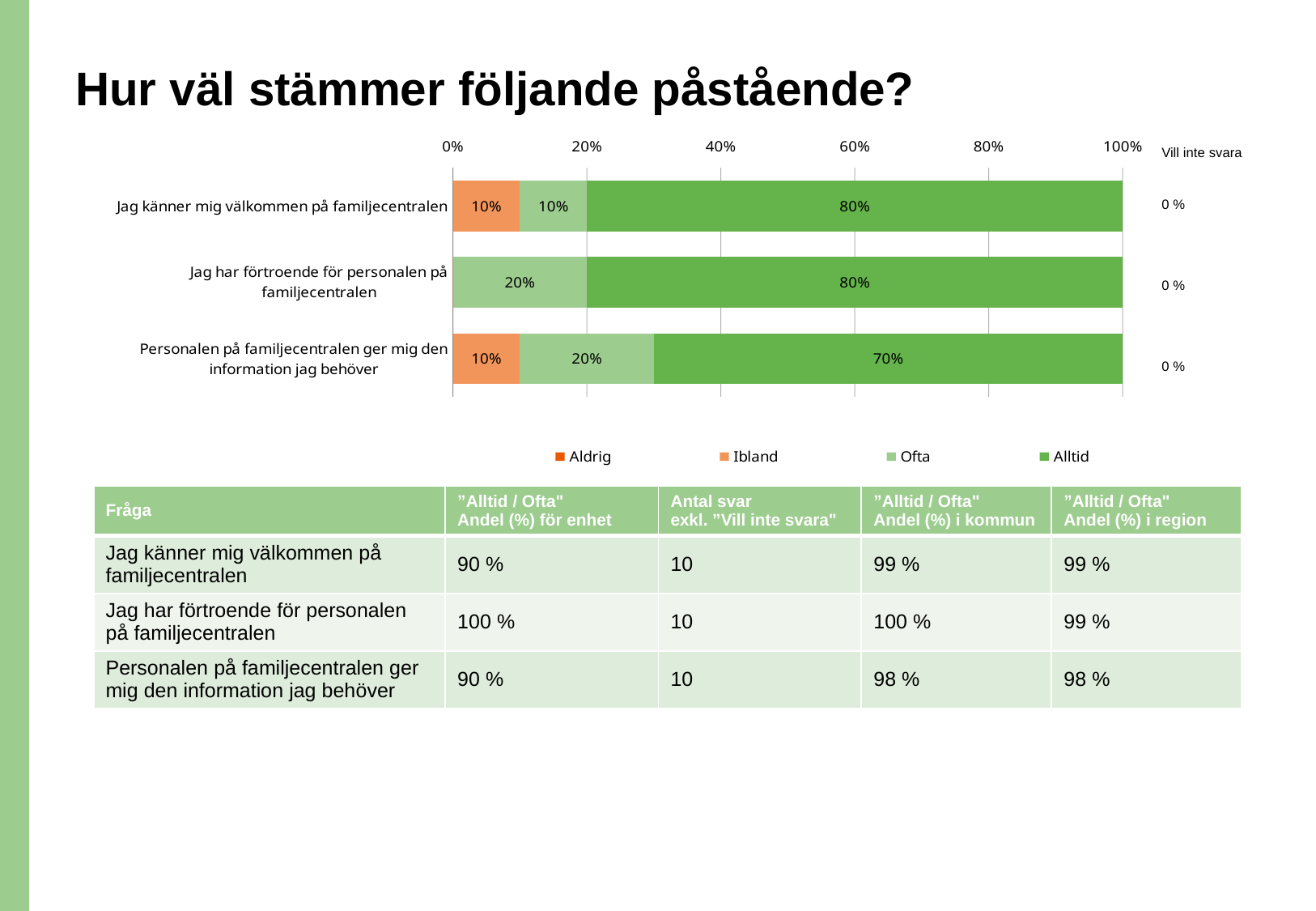
How many statements (categories) are plotted in the chart? 3 What is the "Alltid" value for "Personalen på familjecentralen ger mig den information jag behöver"? 70% Which statement has the lowest "Alltid" value? Personalen på familjecentralen ger mig den information jag behöver What is the difference between the "Alltid" value for "Jag har förtroende för personalen på familjecentralen" and the "Alltid" value for "Personalen på familjecentralen ger mig den information jag behöver"? 10% What is the combined "Ofta" and "Alltid" total for "Jag känner mig välkommen på familjecentralen" in the chart? 90% Which is larger: the "Ofta" value for "Jag känner mig välkommen på familjecentralen" or the "Ofta" value for "Personalen på familjecentralen ger mig den information jag behöver"? Personalen på familjecentralen ger mig den information jag behöver What kind of chart is shown on the slide? bar chart What is the "Ibland" value for "Personalen på familjecentralen ger mig den information jag behöver"? 10% Which legend entry is shown in the darkest green colour? Alltid How many series does the chart legend list? 4 What is the "Ofta" value for "Jag har förtroende för personalen på familjecentralen"? 20% What is the "Alltid" value for "Jag känner mig välkommen på familjecentralen"? 80%